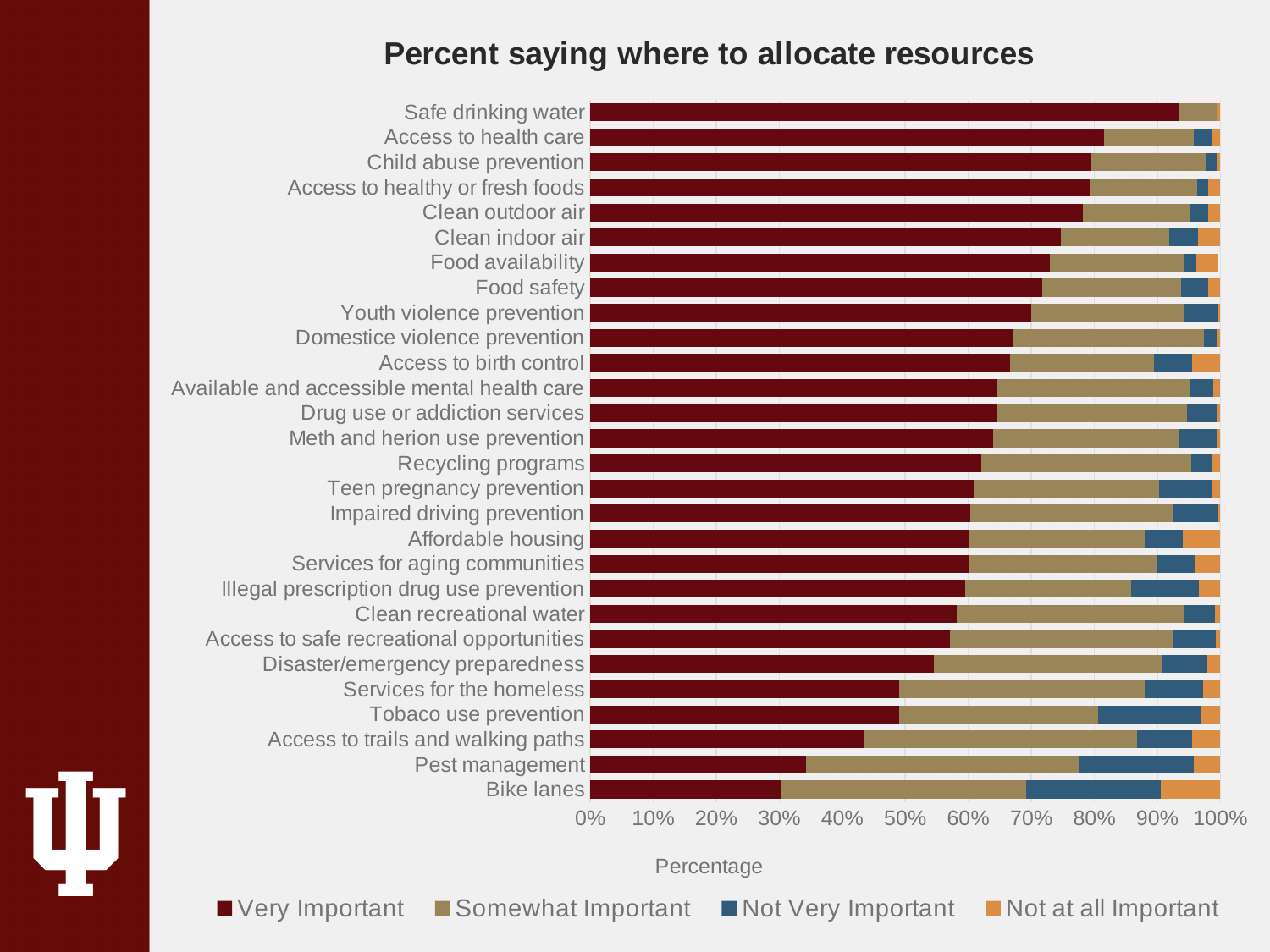
What is the title of the chart? Percent saying where to allocate resources How many series does the legend list? 4 What kind of chart is shown on the slide? Stacked bar chart Which category has the largest 'Not at all Important' segment? Bike lanes Is the 'Very Important' value for Bike lanes greater or less than 40%? less Is the 'Very Important' value for Access to trails and walking paths greater or less than 50%? less Which category has the highest share of 'Very Important' responses? Safe drinking water How many categories are plotted on the chart? 28 Is the 'Very Important' value for Safe drinking water greater or less than 90%? greater Which category has the lowest share of 'Very Important' responses? Bike lanes Which has a larger 'Very Important' share, Pest management or Access to health care? Access to health care